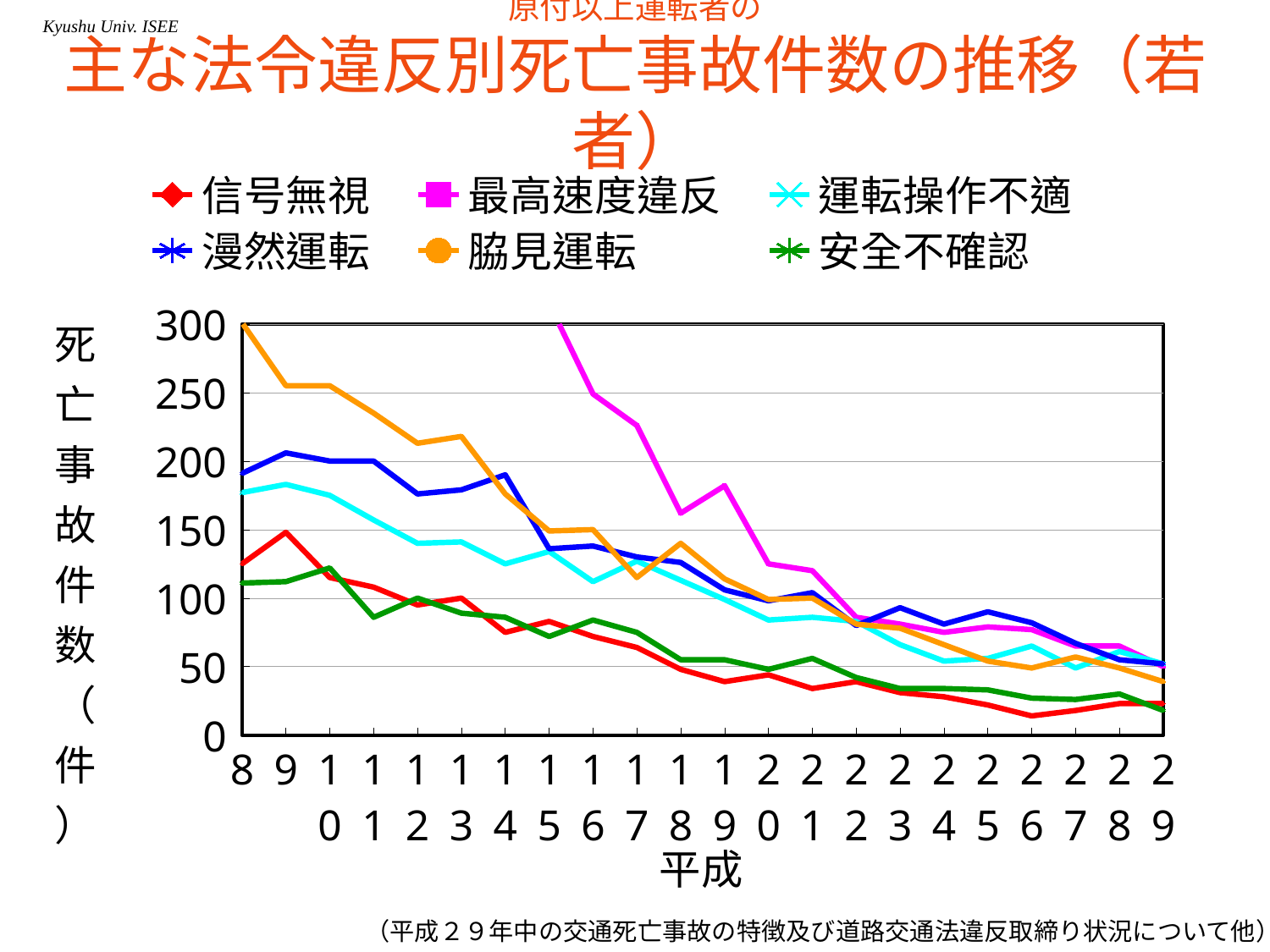
Is the value for 信号無視 in 平成8 greater or less than 100? greater How many series does the legend list? 6 What kind of chart is shown on the slide? line chart Which series has the lowest value in 平成26? 信号無視 In 平成16, which is larger: 最高速度違反 or 安全不確認? 最高速度違反 How many years (points) are plotted along the x axis? 22 Is the value for 最高速度違反 in 平成17 greater or less than 250? less What colour is the 最高速度違反 line? magenta Does the 脇見運転 series generally rise or fall from 平成8 to 平成29? fall Is the value for 信号無視 in 平成26 greater or less than 50? less In 平成8, which is larger: 脇見運転 or 信号無視? 脇見運転